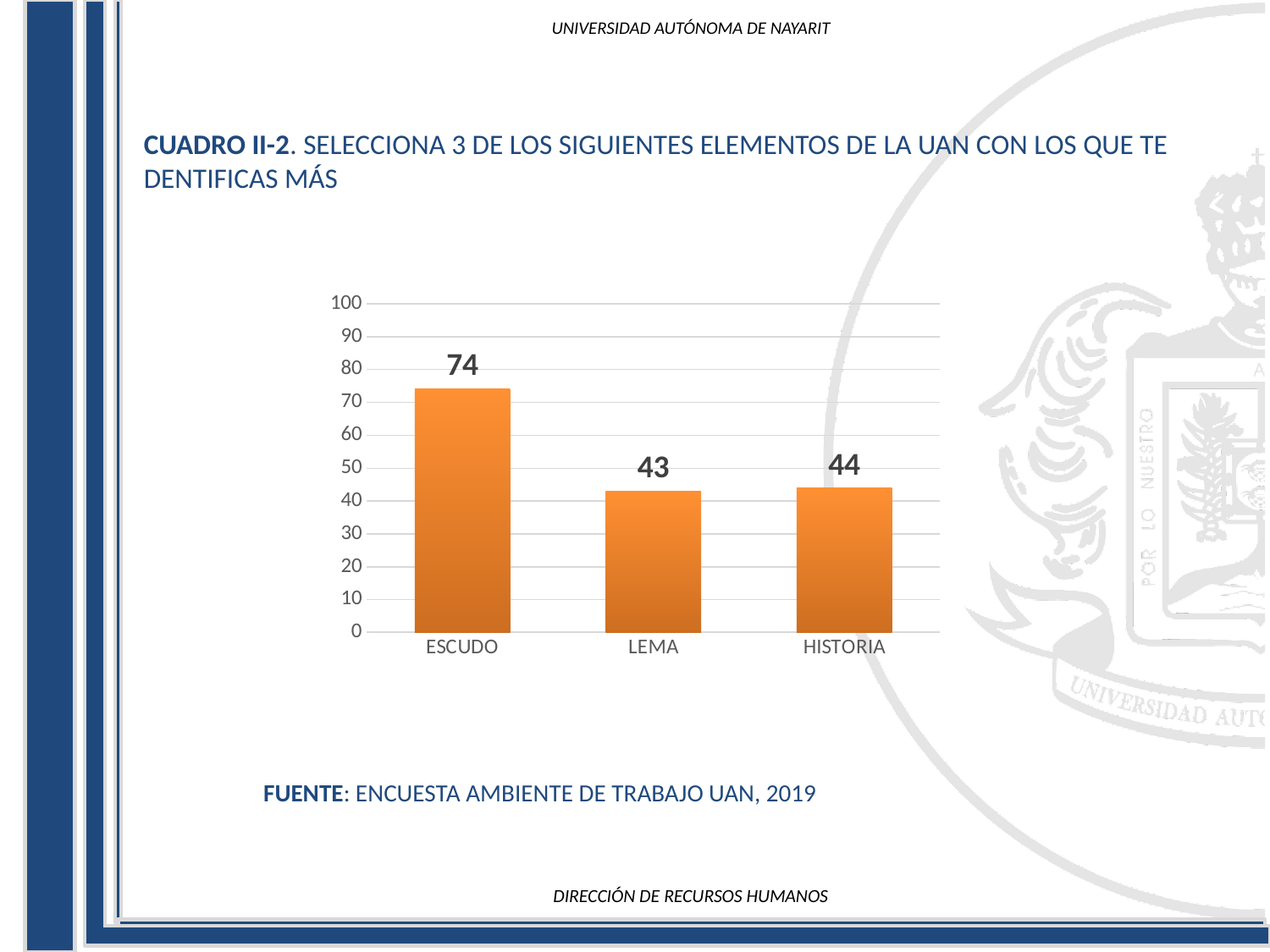
What kind of chart is shown on the slide? bar chart Which is larger, the value for ESCUDO or the value for HISTORIA? ESCUDO What is the value for HISTORIA? 44 Is the value for ESCUDO greater or less than 70? greater What is the value for ESCUDO? 74 What is the difference between the values for HISTORIA and LEMA? 1 Which category has the lowest value? LEMA Which category has the highest value? ESCUDO What is the value for LEMA? 43 Is the value for LEMA greater or less than 50? less What is the difference between the values for ESCUDO and LEMA? 31 How many categories are shown on the x axis? 3